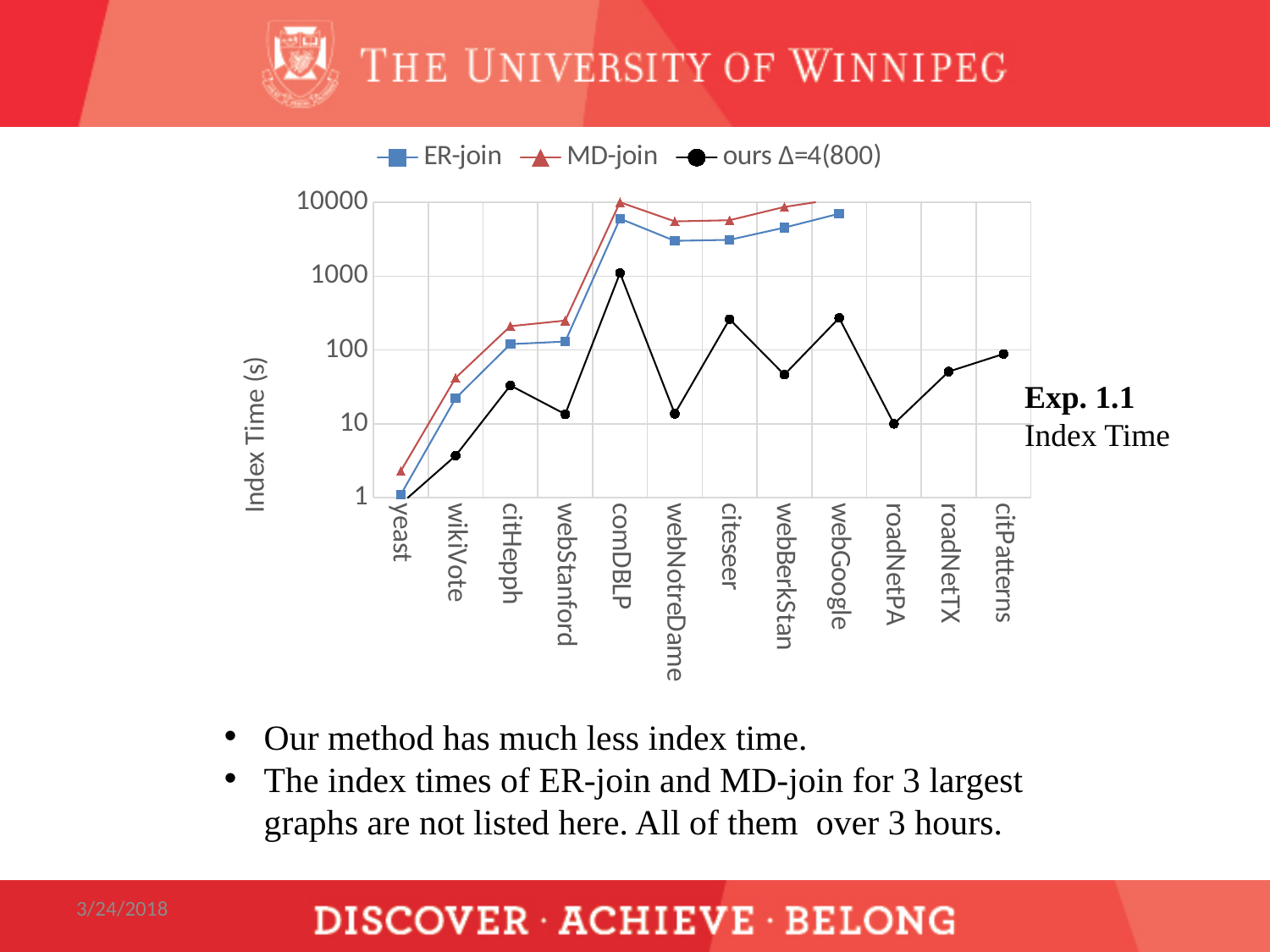
At comDBLP, which series has the higher index time, ER-join or MD-join? MD-join How many datasets (categories) are shown along the x axis? 12 Is the ER-join index time for comDBLP greater or less than 1000? greater For which dataset does the 'ours Δ=4(800)' series reach its highest index time? comDBLP Is the 'ours Δ=4(800)' index time for citHepph greater or less than 100? less What is the label of the y axis? Index Time (s) For the 'ours Δ=4(800)' series, is the index time higher for citeseer or for webBerkStan? citeseer For which dataset does the 'ours Δ=4(800)' series have its lowest index time? yeast How many series does the legend list? 3 What kind of chart is shown on the slide? line chart Is the 'ours Δ=4(800)' index time for citeseer greater or less than 100? greater What is the third series listed in the legend? ours Δ=4(800)